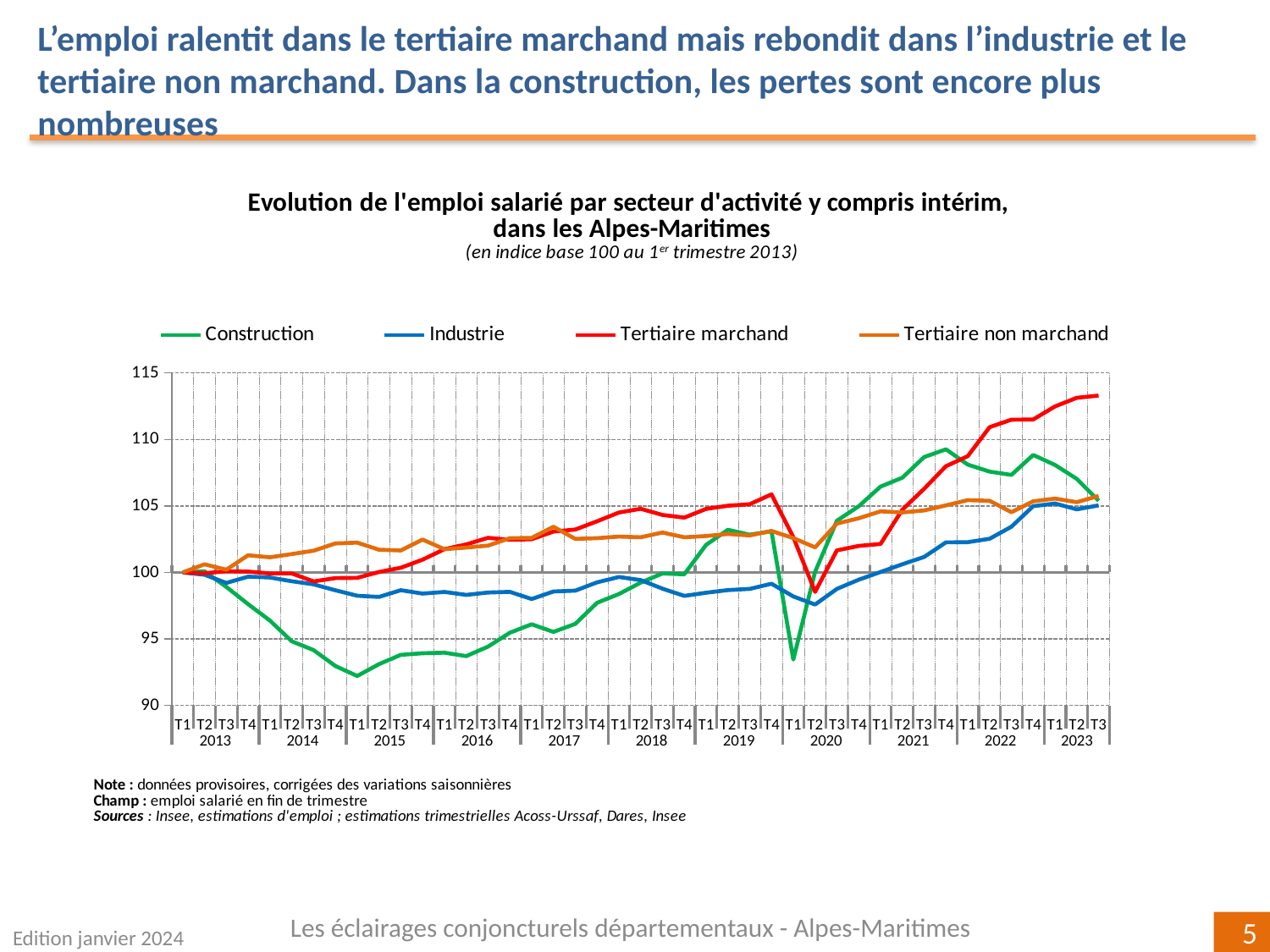
Which series has the lowest value at T1 2015? Construction Which colour is used for the Industrie series? blue Which series has the highest value at T3 2023? Tertiaire marchand Is the value for Tertiaire marchand at T3 2023 greater or less than 110? greater Does the Tertiaire marchand series rise or fall between T1 2021 and T3 2023? rise Is the value for Construction at T4 2021 greater or less than 105? greater At T4 2021, which is higher: Construction or Industrie? Construction Is the value for Construction at T1 2015 greater or less than 95? less How many series does the legend list? 4 What is the value of every series at T1 2013? 100 What kind of chart is shown on the slide? line chart